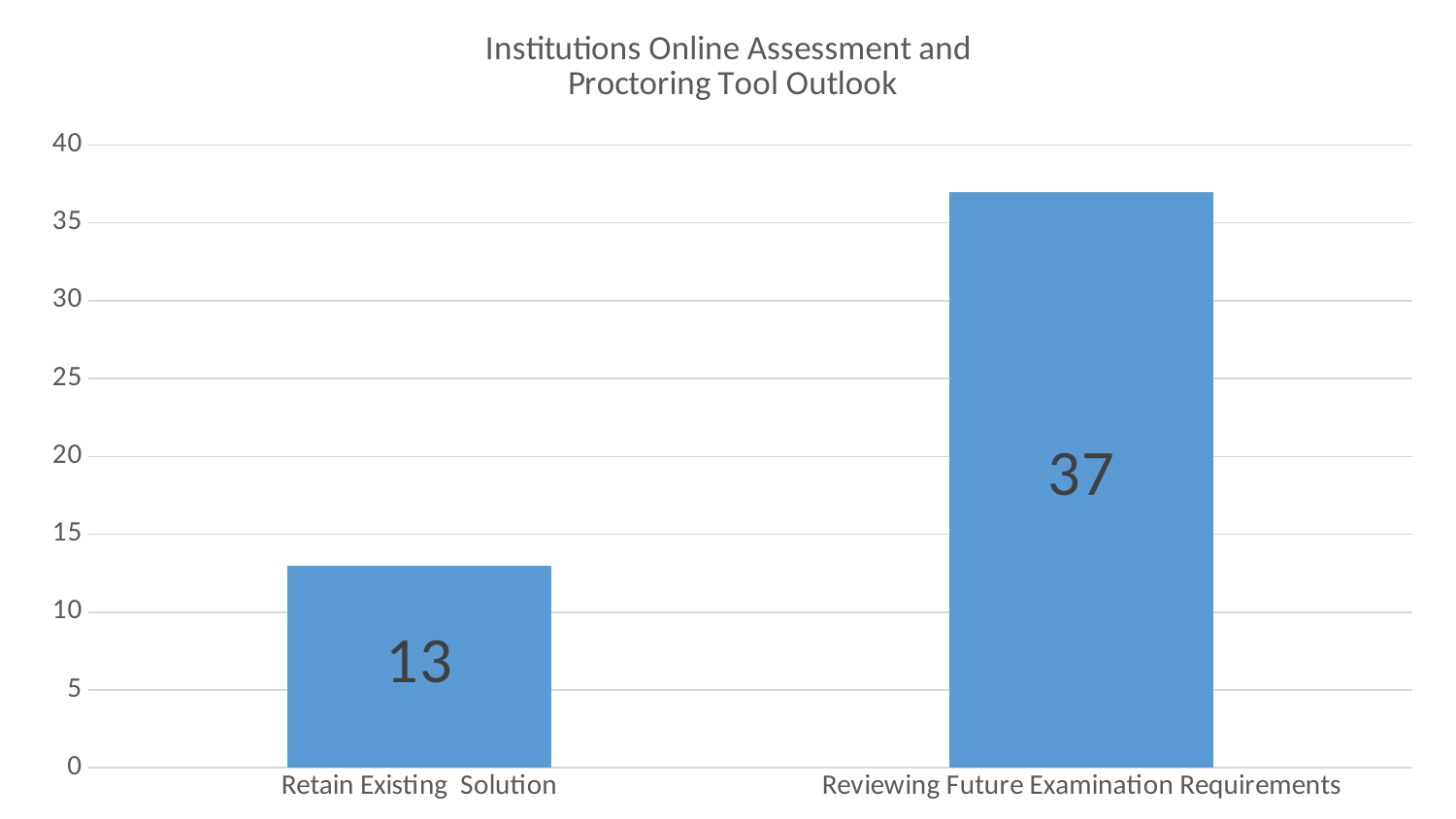
How many categories are shown on the x axis? 2 Which category has the lowest value? Retain Existing Solution What is the value for Retain Existing Solution? 13 Is the value for Reviewing Future Examination Requirements greater or less than 35? greater What is the value for Reviewing Future Examination Requirements? 37 What is the difference between the values for Reviewing Future Examination Requirements and Retain Existing Solution? 24 Which is larger: the value for Retain Existing Solution or the value for Reviewing Future Examination Requirements? Reviewing Future Examination Requirements What is the title of the chart? Institutions Online Assessment and Proctoring Tool Outlook Which category has the highest value? Reviewing Future Examination Requirements Is the value for Retain Existing Solution greater or less than 15? less What is the highest value shown on the vertical axis? 40 What kind of chart is shown on the slide? bar chart